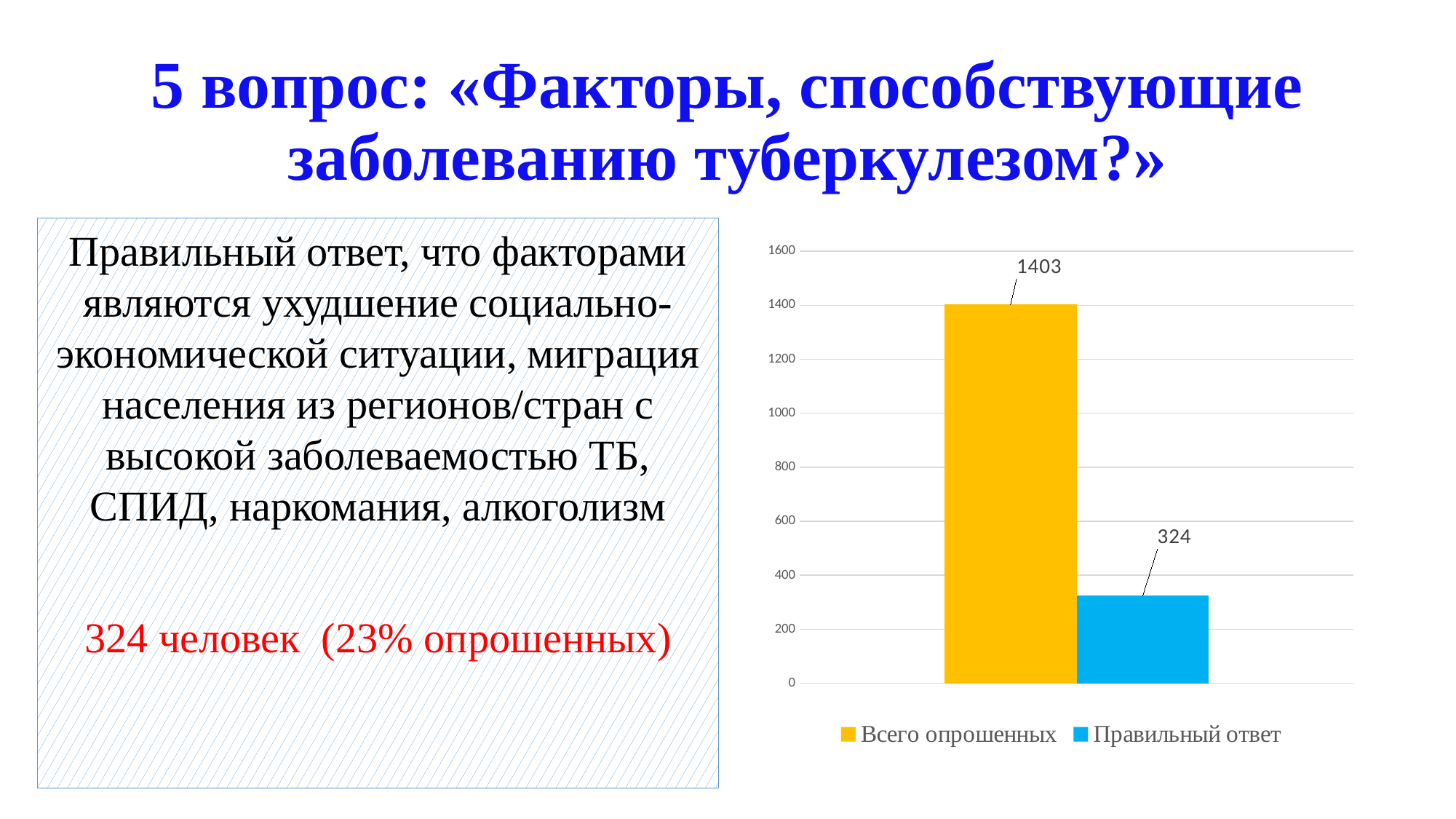
Which series has the lowest value? Правильный ответ Is the value for Правильный ответ greater or less than 400? less How many bars are plotted in the chart? 2 What colour is the bar for Правильный ответ? blue What is the value for Правильный ответ? 324 What is the difference between Всего опрошенных and Правильный ответ? 1079 Which series has the highest value? Всего опрошенных What kind of chart is shown on the slide? bar chart What is the value for Всего опрошенных? 1403 Is the value for Всего опрошенных greater or less than 1200? greater Which is larger, Всего опрошенных or Правильный ответ? Всего опрошенных How many series does the legend list? 2